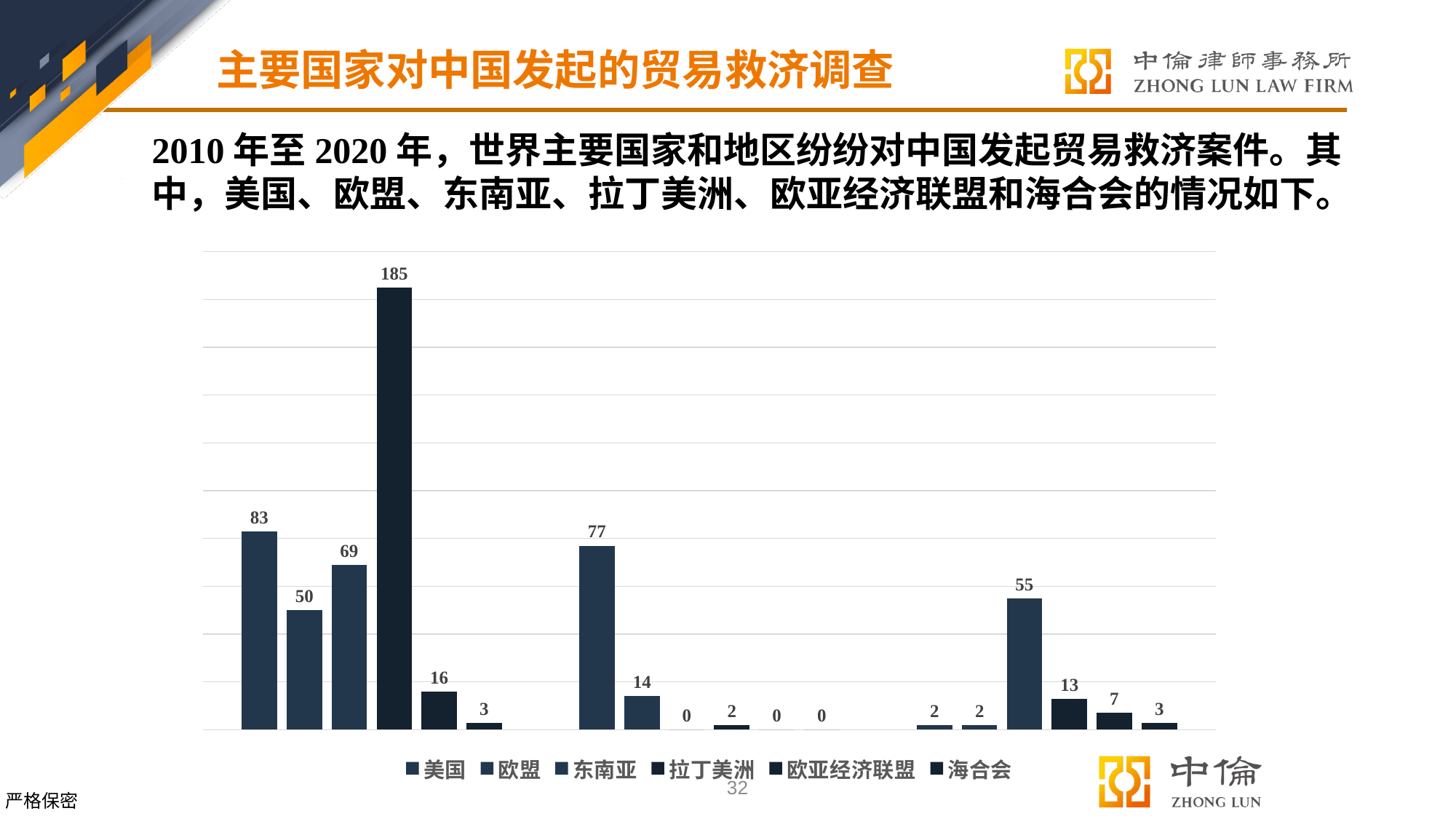
Which is larger: the first bar of the leftmost group (83) or the first bar of the middle group (77)? the first bar of the leftmost group (83) What kind of chart is shown on the slide? bar chart What is the value of the first bar in the middle group? 77 How many series does the chart legend list? 6 How many bars in the middle group have a value of 0? 3 Which series is listed last in the chart legend? 海合会 What is the difference between the first bar (83) and the second bar (50) in the leftmost group? 33 What is the value of the last bar in the leftmost group? 3 How many groups of bars are plotted along the x axis? 3 What is the value of the tallest bar in the rightmost group? 55 What is the value of the tallest bar in the leftmost group of bars? 185 What is the value of the first bar in the leftmost group? 83